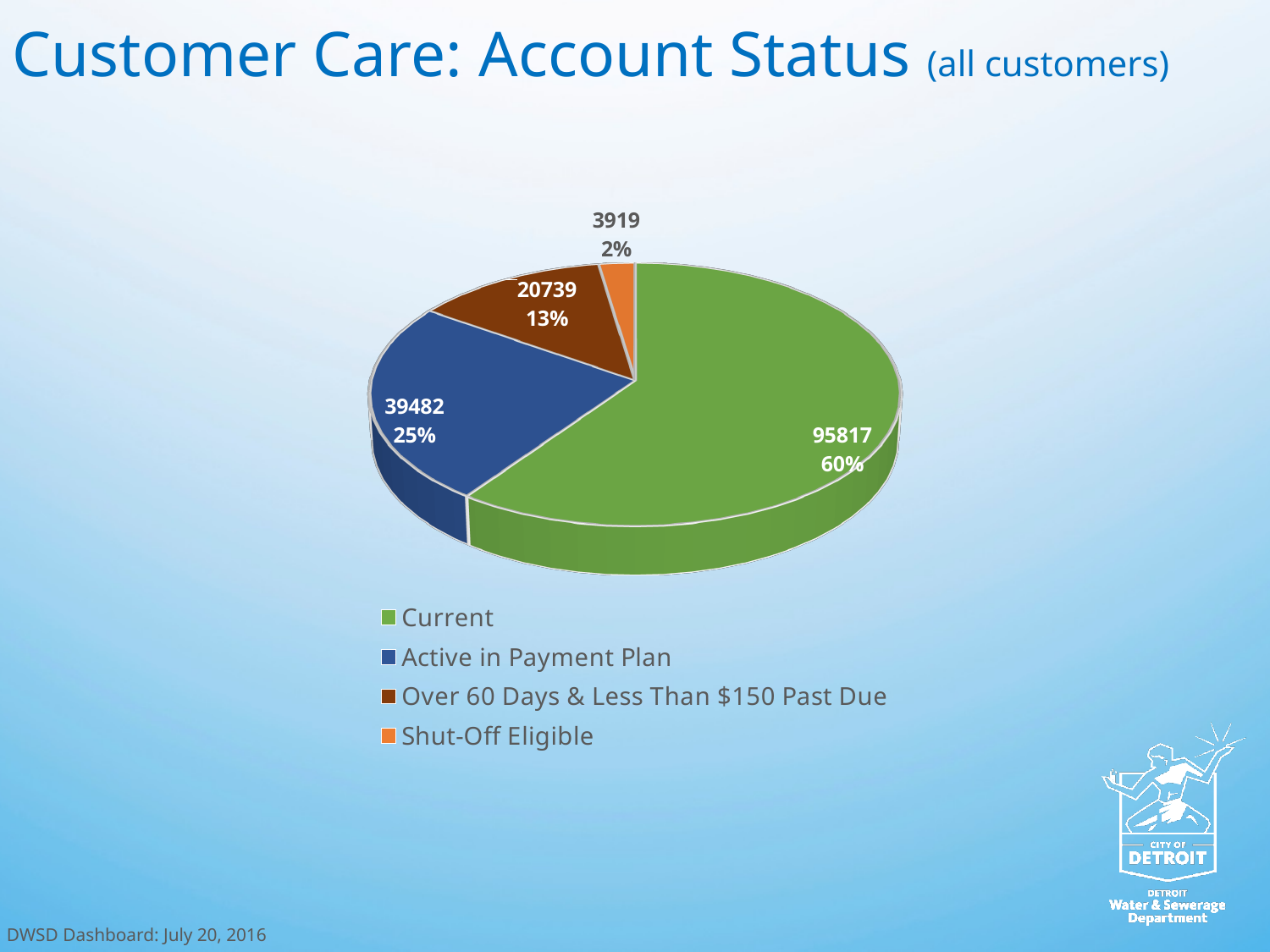
What is the difference between the number of Current customers and the number Active in Payment Plan? 56335 What share of the pie is the Current slice? 60% Which category has the largest slice? Current How many customers are in the Current category? 95817 What kind of chart is shown on the slide? pie chart Which is larger, the Active in Payment Plan slice or the Over 60 Days & Less Than $150 Past Due slice? Active in Payment Plan How many customers are Active in Payment Plan? 39482 What share of the pie is the Shut-Off Eligible slice? 2% How many customers are Shut-Off Eligible? 3919 How many categories does the legend list? 4 How many customers are Over 60 Days & Less Than $150 Past Due? 20739 Which category has the smallest slice? Shut-Off Eligible